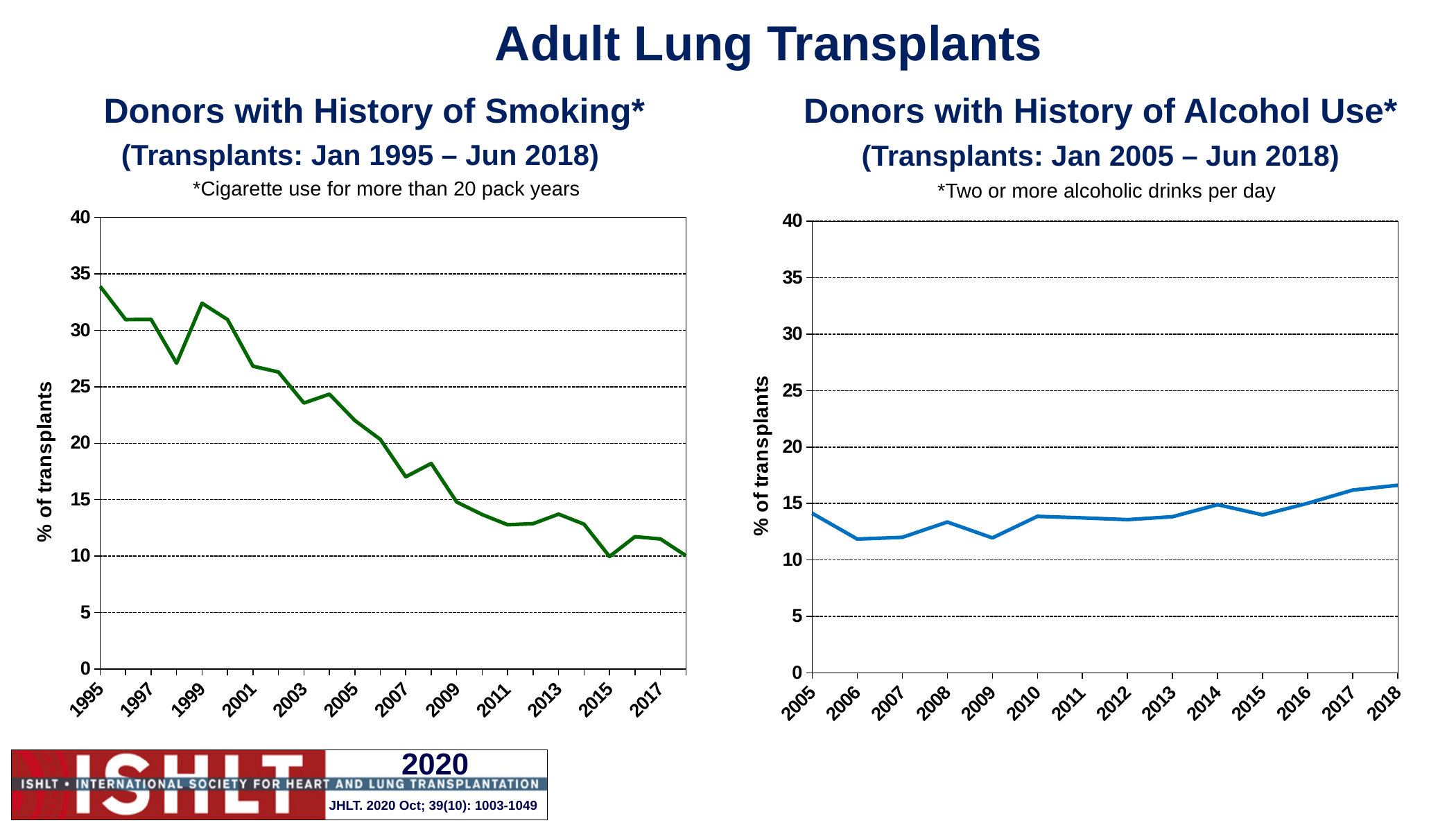
In the 'Donors with History of Alcohol Use' chart, is the value for 2018 greater or less than 15? greater In the 'Donors with History of Smoking' chart, is the value for 2007 greater or less than 20? less What kind of chart is the 'Donors with History of Smoking' chart? line chart What is the y-axis label on the 'Donors with History of Alcohol Use' chart? % of transplants In the 'Donors with History of Alcohol Use' chart, is the value for 2006 greater or less than 15? less In the 'Donors with History of Smoking' chart, which year has the highest value? 1995 In the 'Donors with History of Smoking' chart, do the values generally rise or fall from 1995 to 2018? fall In the 'Donors with History of Alcohol Use' chart, do the values generally rise or fall from 2005 to 2018? rise How many years are plotted on the x axis of the 'Donors with History of Alcohol Use' chart? 14 Which is larger: the 1995 value in the 'Donors with History of Smoking' chart or the 2005 value in the 'Donors with History of Alcohol Use' chart? the 1995 value in the smoking chart